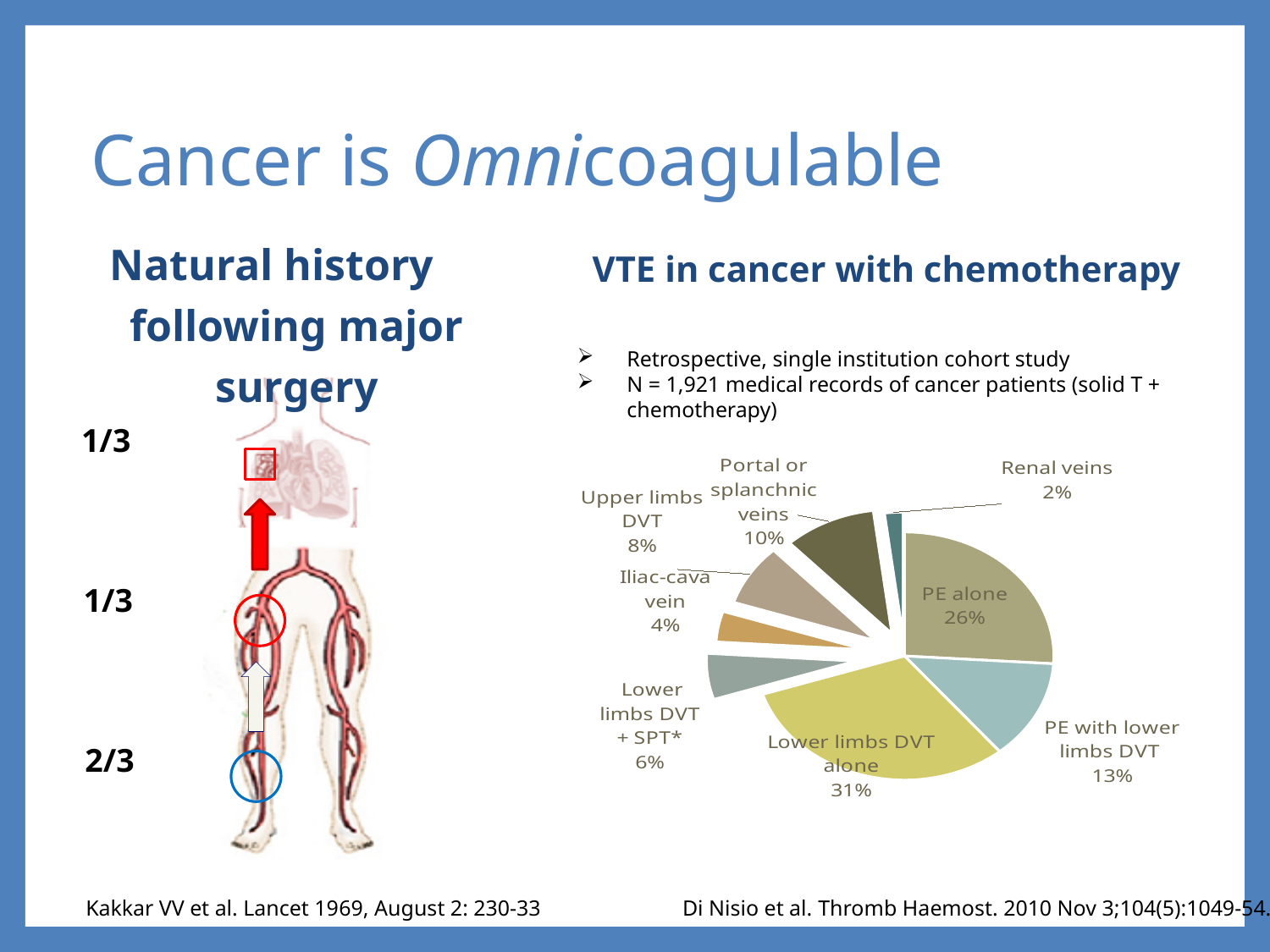
What type of chart is shown on the slide? pie chart Which category has the largest share of the pie chart? Lower limbs DVT alone What percentage of VTE cases is attributed to PE alone? 26% What is the difference in percentage points between lower limbs DVT alone and PE alone? 5 What percentage of VTE cases is attributed to lower limbs DVT alone? 31% Which category has the smallest share of the pie chart? Renal veins What is the combined share of PE alone and PE with lower limbs DVT? 39% What is the title of the section containing the pie chart? VTE in cancer with chemotherapy Which is larger: the share for upper limbs DVT or the share for iliac-cava vein? Upper limbs DVT How many categories are shown in the pie chart? 8 What percentage of VTE cases is attributed to portal or splanchnic veins? 10% What percentage of VTE cases is attributed to renal veins? 2%